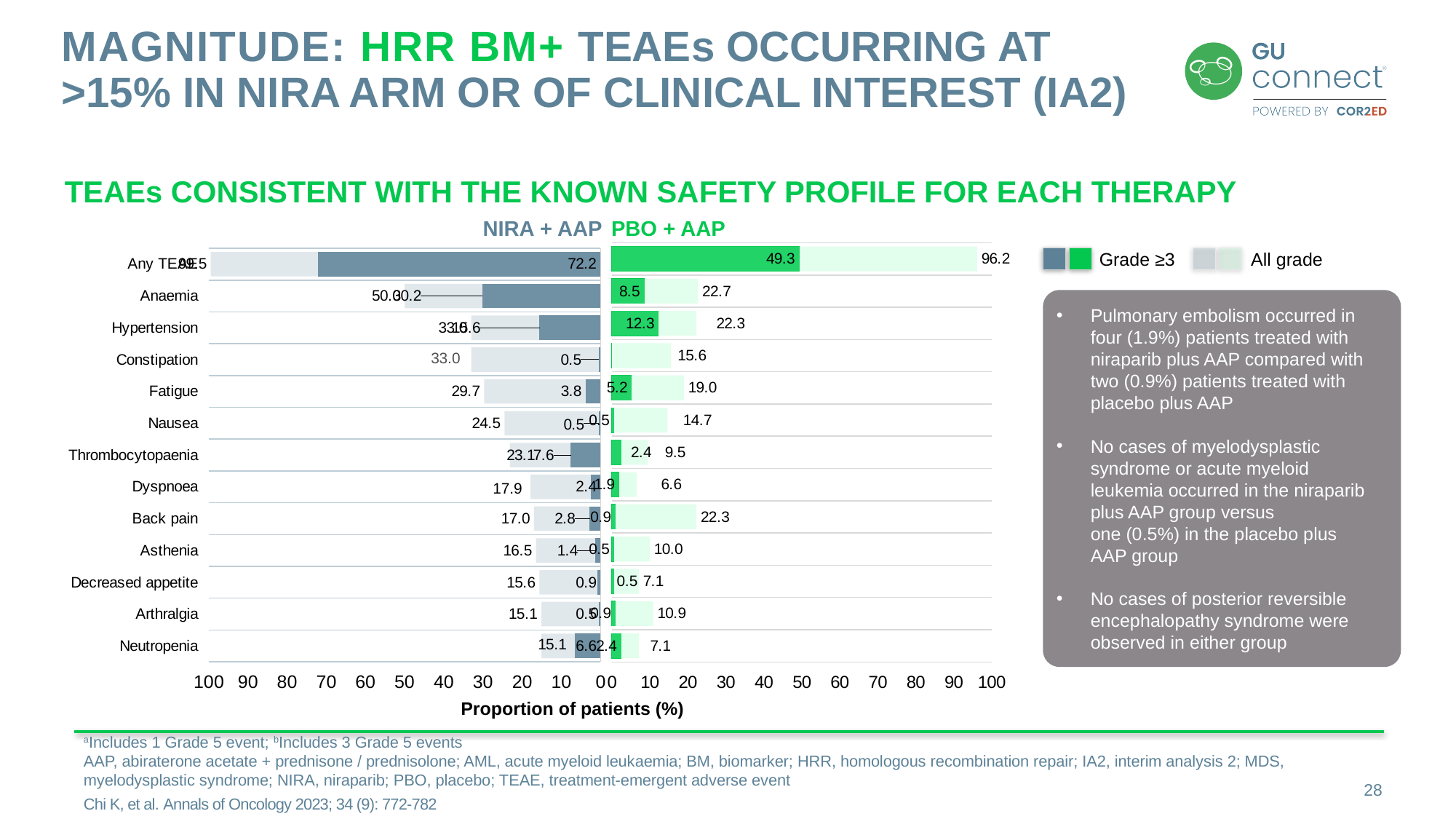
What kind of chart is shown on the slide? Bar chart How many TEAE categories are listed on the chart? 13 How many series does the chart legend list? 2 Which arm has the higher all-grade proportion for fatigue, NIRA + AAP or PBO + AAP? NIRA + AAP What is the all-grade proportion for fatigue in the NIRA + AAP arm? 29.7 What is the difference in Grade ≥3 any-TEAE proportion between the NIRA + AAP arm (72.2) and the PBO + AAP arm (49.3)? 22.9 Is the all-grade proportion for anaemia in the NIRA + AAP arm greater or less than 40? greater What is the Grade ≥3 proportion of patients with any TEAE in the NIRA + AAP arm? 72.2 What is the all-grade proportion for back pain in the PBO + AAP arm? 22.3 What is the Grade ≥3 proportion for hypertension in the PBO + AAP arm? 12.3 What is the label of the horizontal axis of the chart? Proportion of patients (%) What is the all-grade proportion of patients with any TEAE in the PBO + AAP arm? 96.2